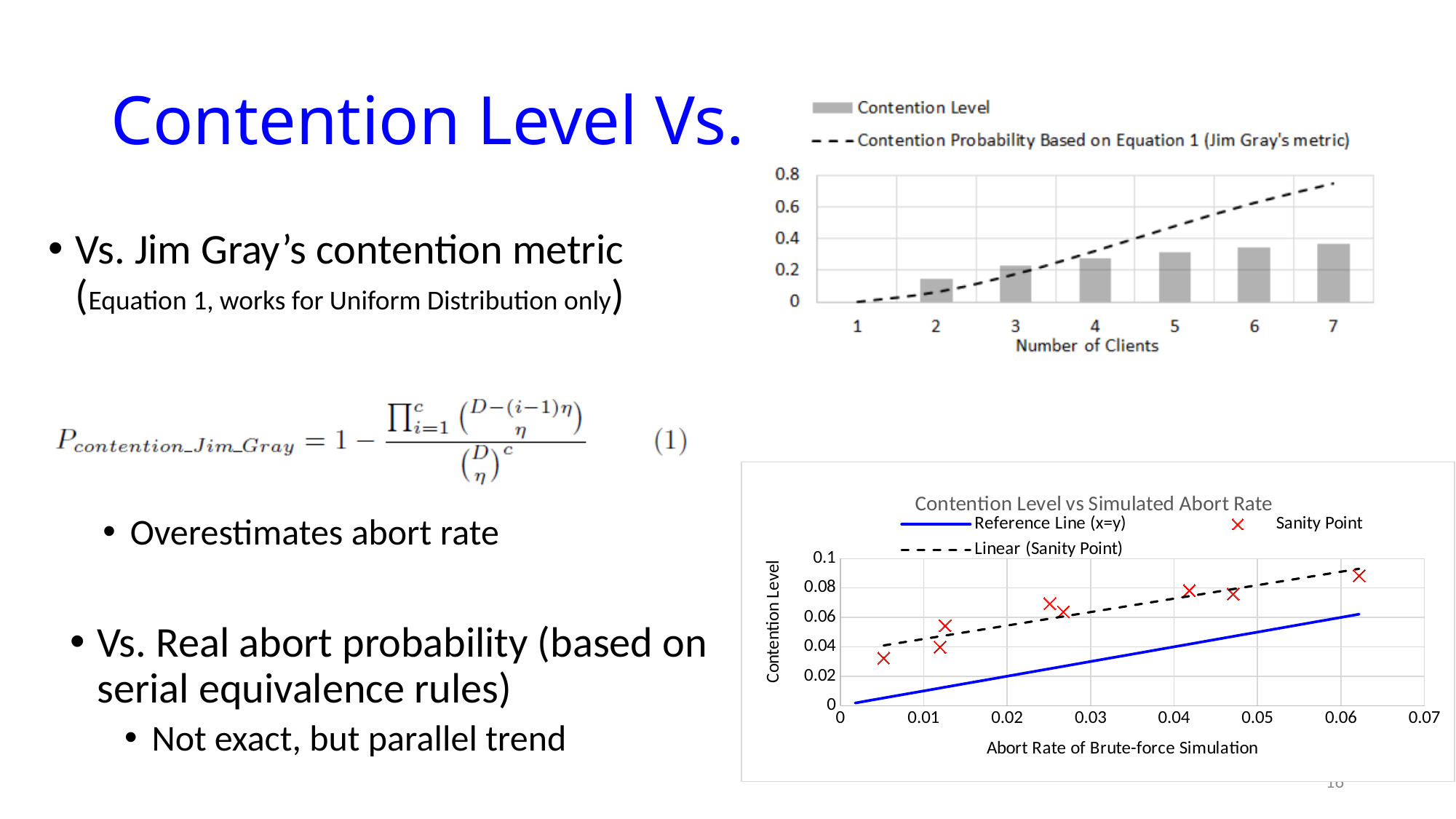
In the top-right chart (Contention Level vs Number of Clients), is the Contention Level for 7 clients greater or less than 0.4? less In the top-right chart (Contention Level vs Number of Clients), how many series does the legend list? 2 What is the title of the bottom-right chart? Contention Level vs Simulated Abort Rate In the bottom-right chart (Contention Level vs Simulated Abort Rate), do the Sanity Point values rise or fall as the Abort Rate of Brute-force Simulation increases? rise What kind of chart is the top-right chart plotting Contention Level against Number of Clients? bar chart In the top-right chart (Contention Level vs Number of Clients), how many values of Number of Clients are shown on the x axis? 7 In the bottom-right chart (Contention Level vs Simulated Abort Rate), how many entries does the legend list? 3 In the top-right chart (Contention Level vs Number of Clients), which is larger at 7 clients: the Contention Level bar or the Contention Probability Based on Equation 1 line? Contention Probability Based on Equation 1 In the top-right chart (Contention Level vs Number of Clients), is the Contention Level for 2 clients greater or less than 0.2? less In the top-right chart (Contention Level vs Number of Clients), do the Contention Level bars rise or fall as the number of clients increases? rise In the top-right chart (Contention Level vs Number of Clients), which number of clients has the highest Contention Level bar? 7 In the top-right chart (Contention Level vs Number of Clients), is the Contention Probability Based on Equation 1 at 7 clients greater or less than 0.6? greater